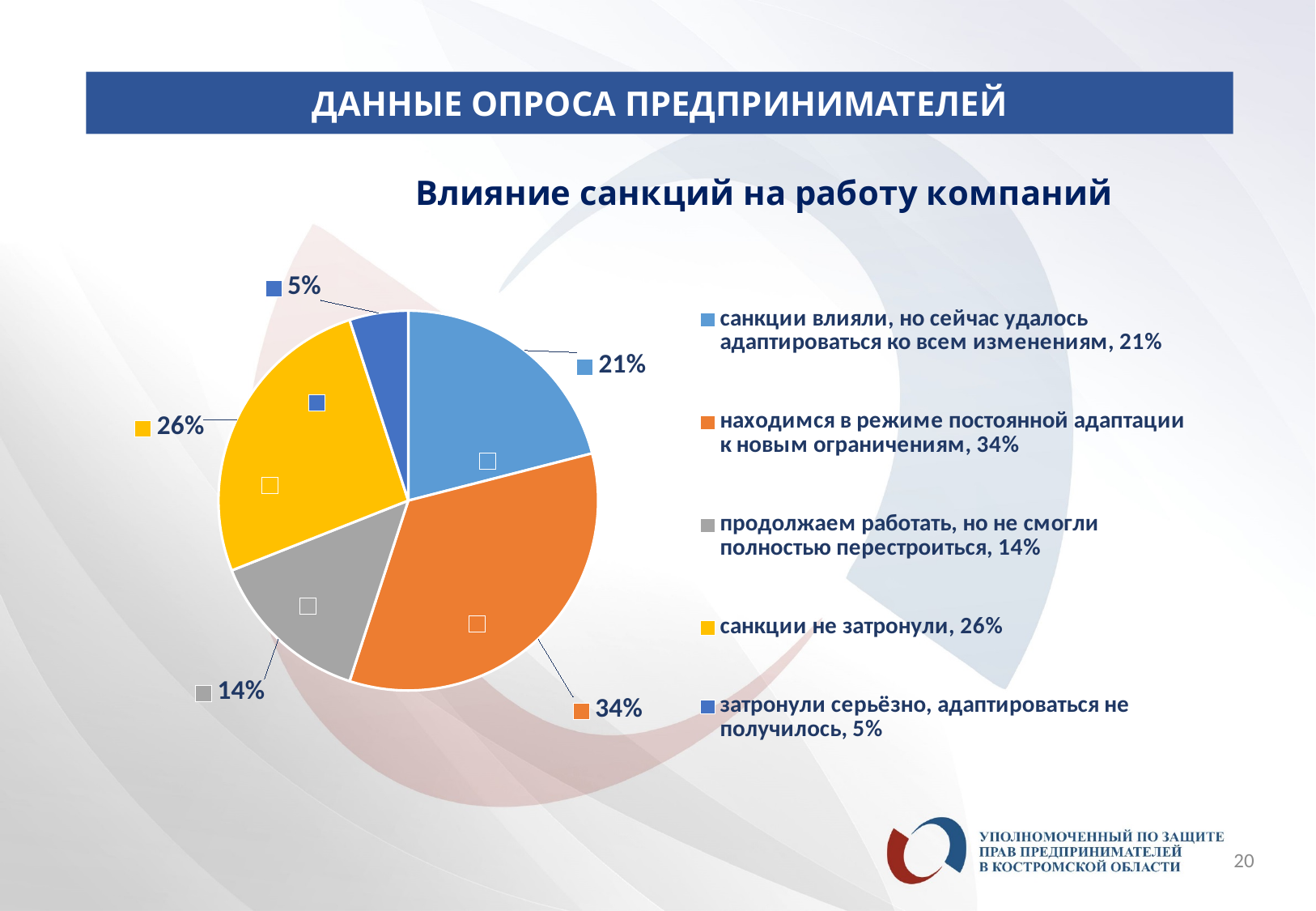
How many slices does the pie chart have? 5 What is the difference between the share for "санкции не затронули" and the share for "санкции влияли, но сейчас удалось адаптироваться ко всем изменениям"? 5% What share of respondents answered "продолжаем работать, но не смогли полностью перестроиться"? 14% What share of respondents answered "санкции не затронули"? 26% Which category has the largest share of the pie? находимся в режиме постоянной адаптации к новым ограничениям What kind of chart is shown on the slide? pie chart What colour is the slice for "санкции не затронули"? yellow What share of respondents answered "затронули серьёзно, адаптироваться не получилось"? 5% What is the chart's title? Влияние санкций на работу компаний Which category has the smallest share of the pie? затронули серьёзно, адаптироваться не получилось Which is larger: the share for "продолжаем работать, но не смогли полностью перестроиться" or the share for "санкции влияли, но сейчас удалось адаптироваться ко всем изменениям"? санкции влияли, но сейчас удалось адаптироваться ко всем изменениям What share of respondents answered "находимся в режиме постоянной адаптации к новым ограничениям"? 34%